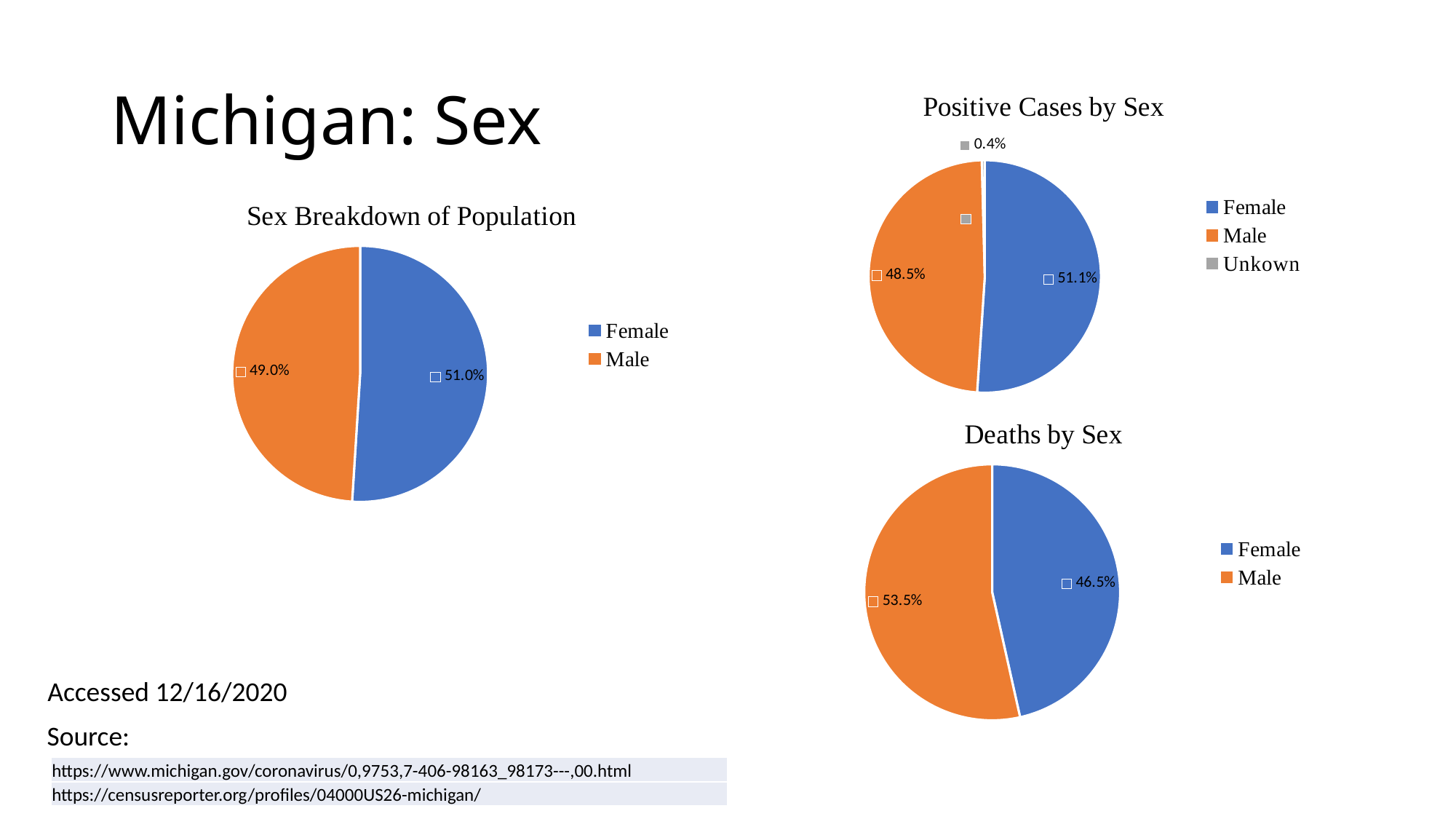
In the 'Positive Cases by Sex' chart, which category has the smallest share? Unkown In the 'Positive Cases by Sex' chart, what percentage of positive cases is Unkown? 0.4% How many categories does the legend of the 'Positive Cases by Sex' chart list? 3 In the 'Deaths by Sex' chart, which category has the largest share? Male What kind of chart is 'Deaths by Sex'? Pie chart In the 'Positive Cases by Sex' chart, what percentage of positive cases is Male? 48.5% In the 'Sex Breakdown of Population' chart, what share of the population is Male? 49.0% In the 'Deaths by Sex' chart, what percentage of deaths is Female? 46.5% In the 'Positive Cases by Sex' chart, is the Female share larger or the Male share larger? Female In the 'Deaths by Sex' chart, what is the difference between the Male and Female shares? 7.0% How many charts are shown on the slide? 3 In the 'Sex Breakdown of Population' chart, what share of the population is Female? 51.0%